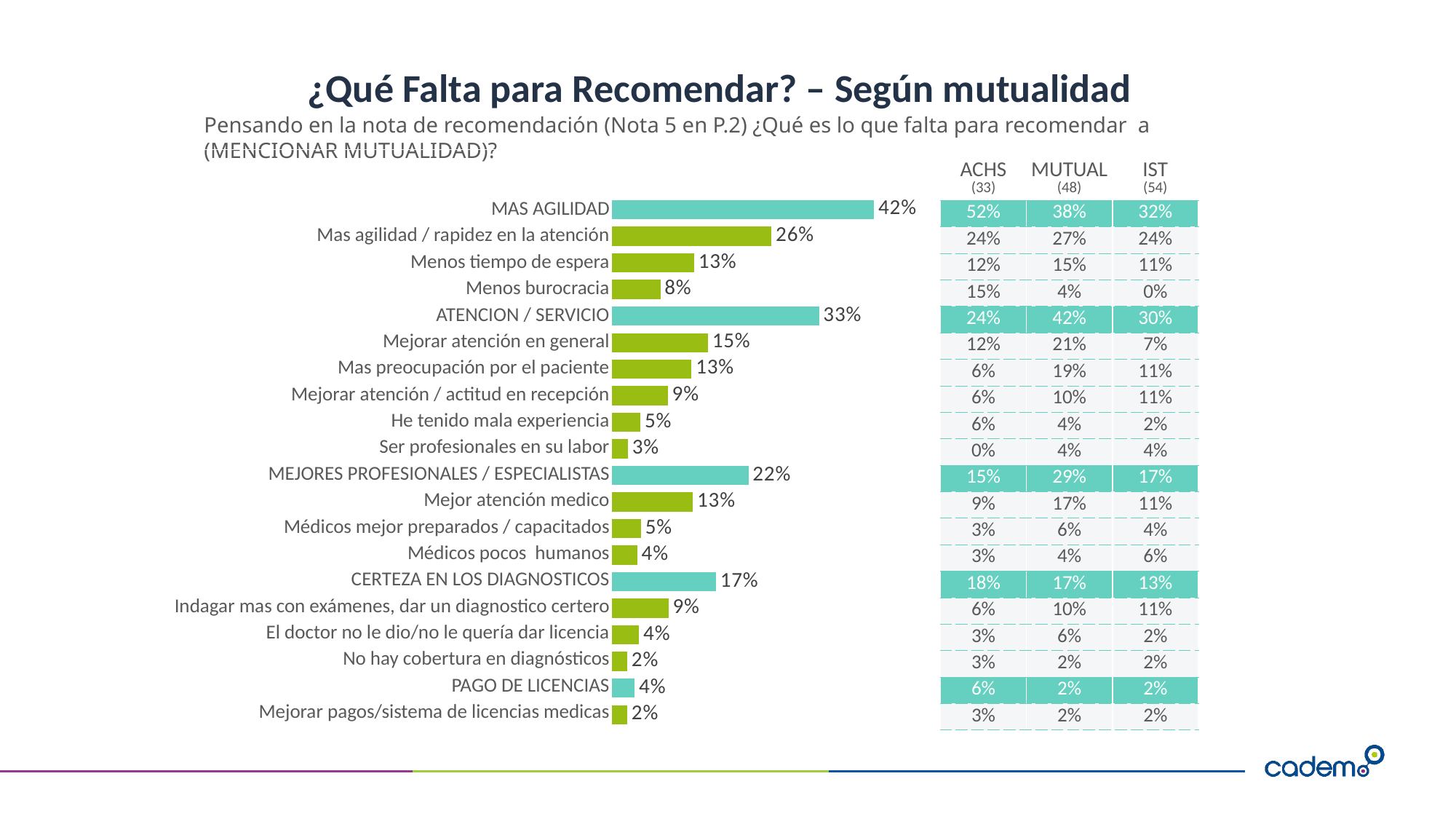
What is the value for PAGO DE LICENCIAS in the bar chart? 4% What is the difference between MAS AGILIDAD and ATENCION / SERVICIO in the bar chart? 9% What is the value for MAS AGILIDAD in the bar chart? 42% What is the value for ATENCION / SERVICIO in the bar chart? 33% Which category has the highest value in the bar chart? MAS AGILIDAD What is the lowest value shown in the bar chart? 2% What is the title of the slide? ¿Qué Falta para Recomendar? – Según mutualidad What is the value for Menos burocracia in the bar chart? 8% Which is larger in the bar chart: Mas agilidad / rapidez en la atención or Mejorar atención en general? Mas agilidad / rapidez en la atención How many bars are shown in the bar chart? 20 What type of chart is shown on the slide? Bar chart What is the value for CERTEZA EN LOS DIAGNOSTICOS in the bar chart? 17%